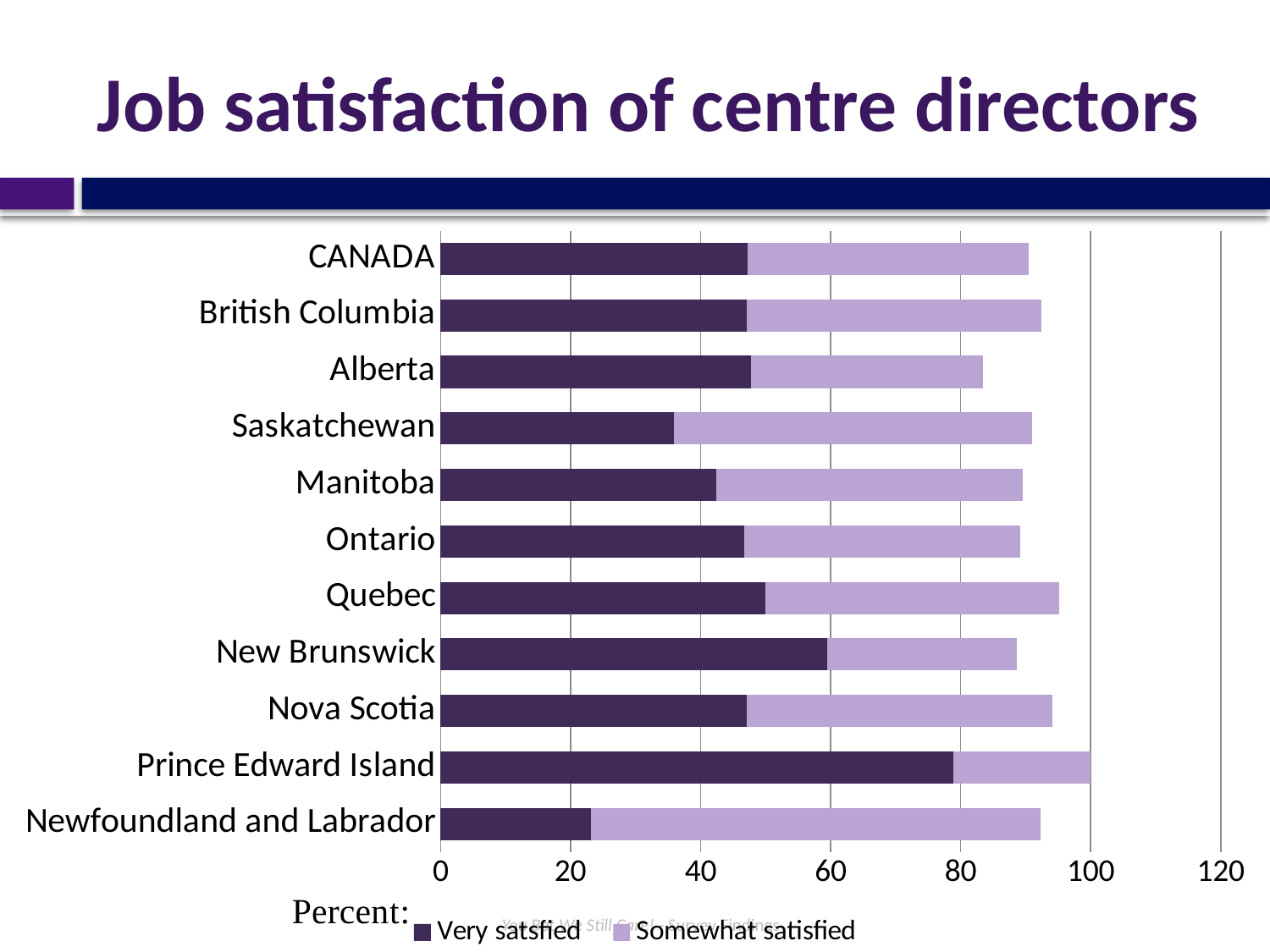
Which has the larger 'Very satisfied' value, Quebec or Saskatchewan? Quebec Is the 'Very satisfied' value for Newfoundland and Labrador greater or less than 40? less Which region has the longest total bar (Very satisfied plus Somewhat satisfied)? Prince Edward Island What kind of chart is shown on the slide? Stacked bar chart Is the 'Very satisfied' value for Prince Edward Island greater or less than 60? greater Is the 'Very satisfied' value for Saskatchewan greater or less than 40? less How many categories (regions) are plotted on the chart? 11 What is the title of the chart on the slide? Job satisfaction of centre directors Which series is shown in the darker purple colour? Very satsfied Which region has the lowest 'Very satisfied' value? Newfoundland and Labrador How many series does the legend list? 2 Which region has the highest 'Very satisfied' value? Prince Edward Island